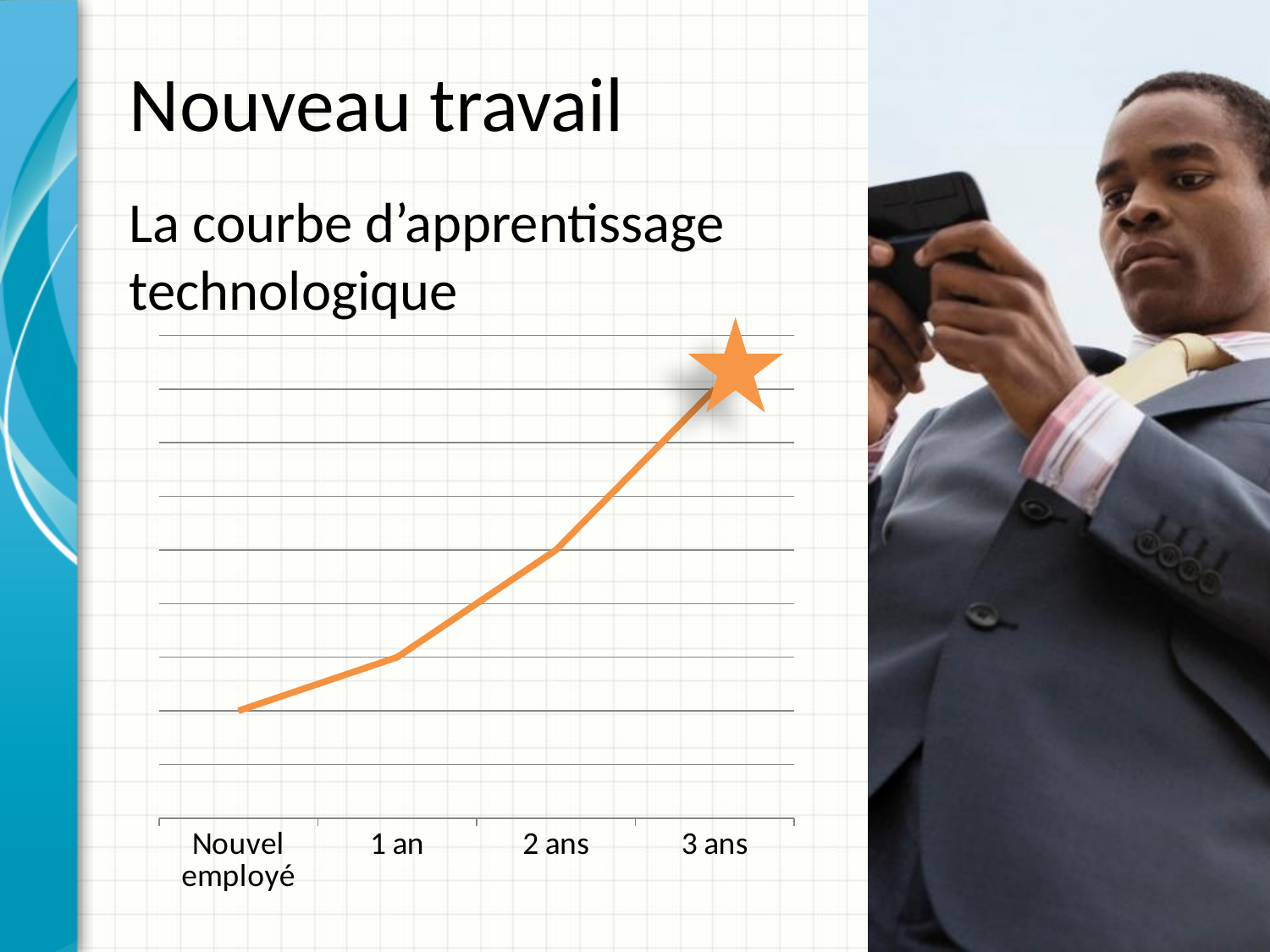
Which is larger, the value for 2 ans or the value for 3 ans? 3 ans What colour is the line plotted on the chart? orange How many categories are shown on the x axis of the chart? 4 Do the values rise or fall from Nouvel employé to 3 ans? rise What is the first category label on the x axis of the chart? Nouvel employé Which is larger, the value for 1 an or the value for 3 ans? 3 ans Which category has the highest value on the chart? 3 ans What kind of chart is shown on the slide? line chart Which category has the lowest value on the chart? Nouvel employé Which is larger, the value for Nouvel employé or the value for 2 ans? 2 ans